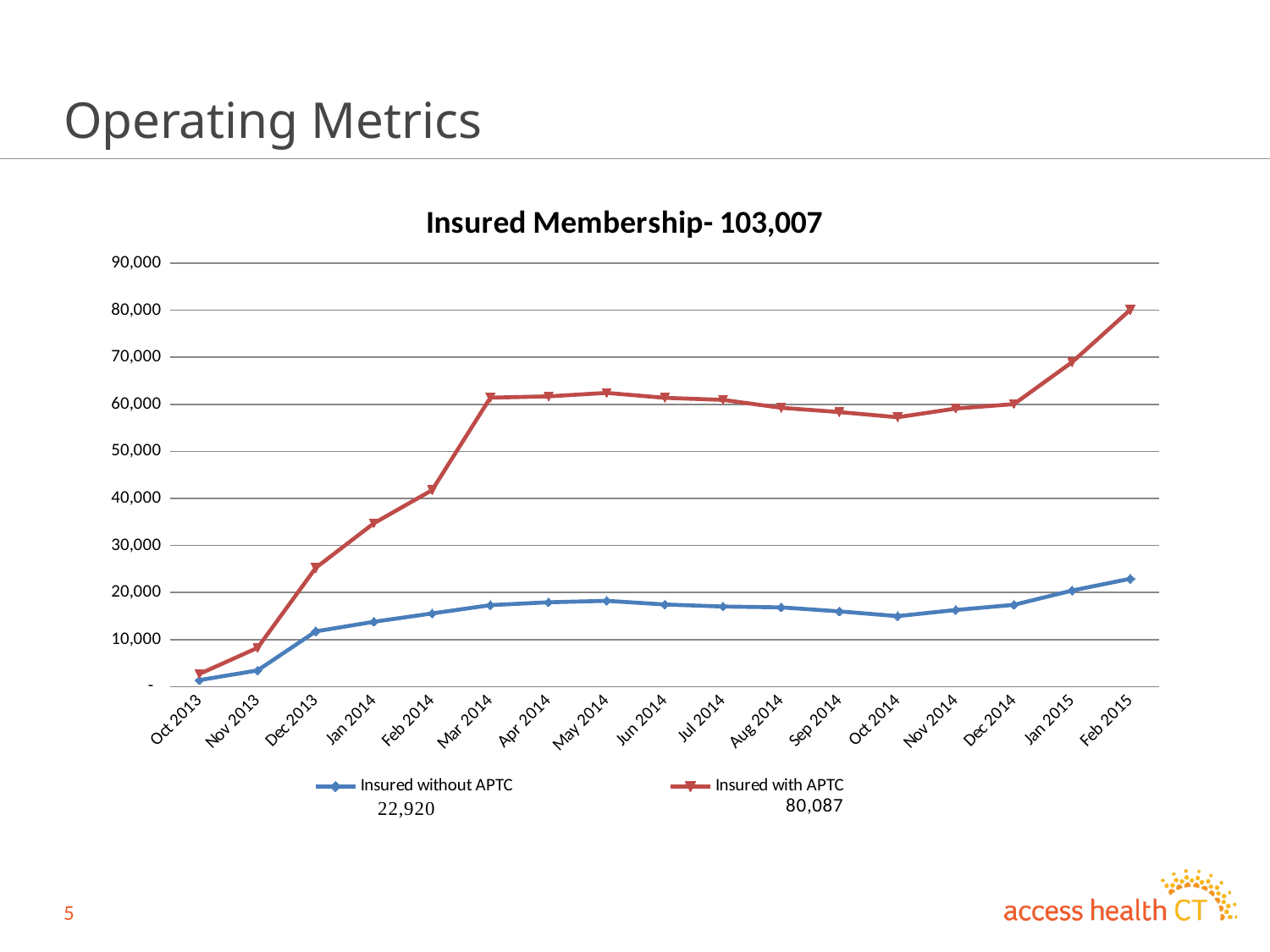
What is the title of the chart? Insured Membership- 103,007 Is the value for Insured without APTC in Oct 2014 greater or less than 20,000? less How many series does the legend list? 2 What value is printed beneath the legend entry for Insured without APTC? 22,920 In Feb 2015, which series has the larger value, Insured with APTC or Insured without APTC? Insured with APTC What is the difference between the printed values for Insured with APTC (80,087) and Insured without APTC (22,920)? 57,167 Does the Insured with APTC series rise or fall from Oct 2013 to Mar 2014? rise In which month does the Insured with APTC series reach its highest value? Feb 2015 What kind of chart is shown on the slide? line chart Is the value for Insured with APTC in Dec 2013 greater or less than 20,000? greater How many months are plotted along the x axis? 17 What value is printed beneath the legend entry for Insured with APTC? 80,087